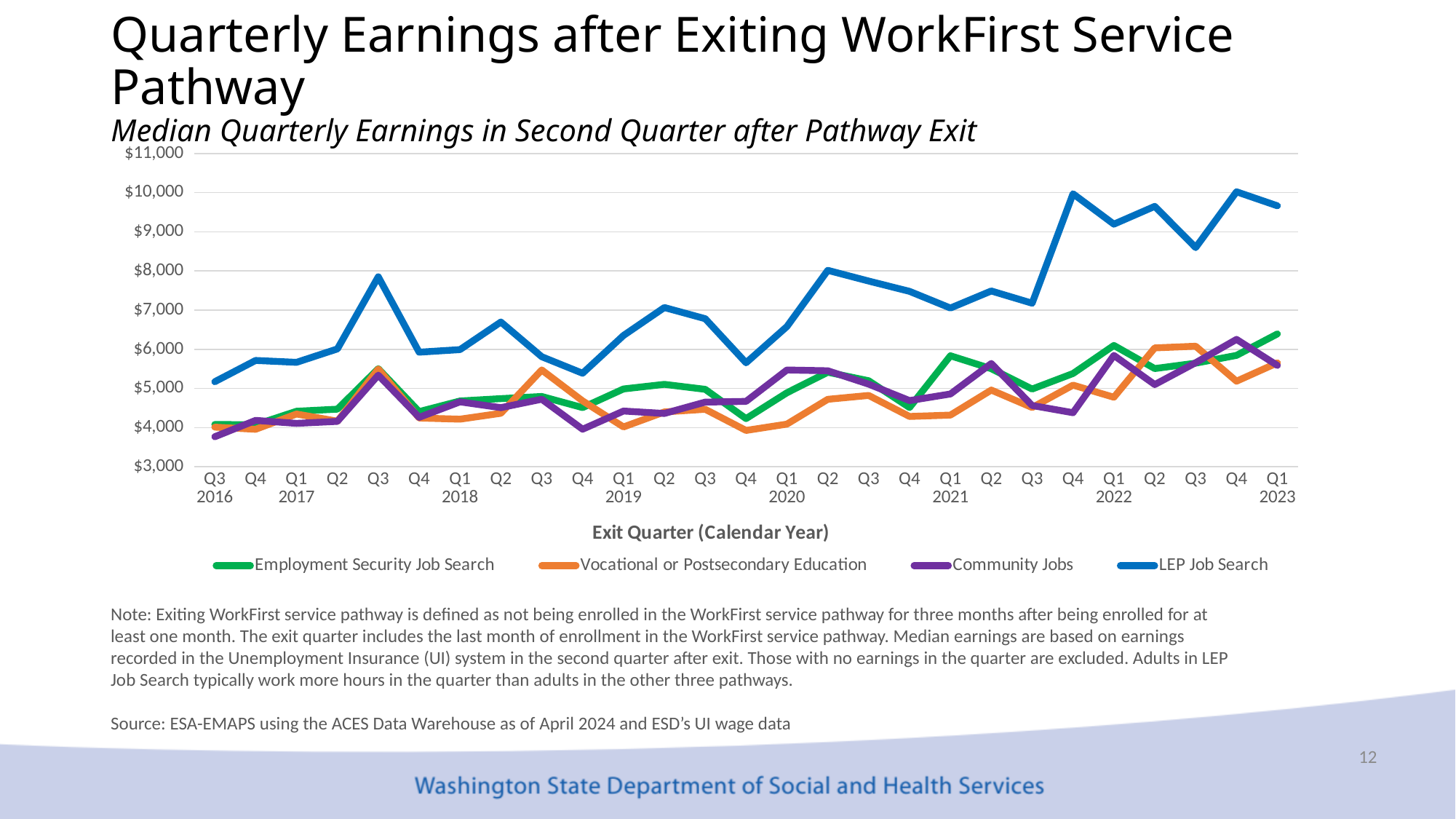
Is the value for Employment Security Job Search at Q1 2023 greater or less than $6,000? greater How many series does the legend list? 4 At Q1 2021, which is higher: Employment Security Job Search or Vocational or Postsecondary Education? Employment Security Job Search How many exit quarters are plotted along the x axis? 27 Does the LEP Job Search line generally rise or fall from Q3 2016 to Q1 2023? Rise Which series has the highest median quarterly earnings at Q1 2023? LEP Job Search What kind of chart is shown on the slide? Line chart Is the value for LEP Job Search at Q3 2022 greater or less than $8,000? greater Is the value for LEP Job Search at Q3 2017 greater or less than $7,000? greater Which series has the lowest median quarterly earnings at Q3 2016? Community Jobs What is the label of the x axis? Exit Quarter (Calendar Year)